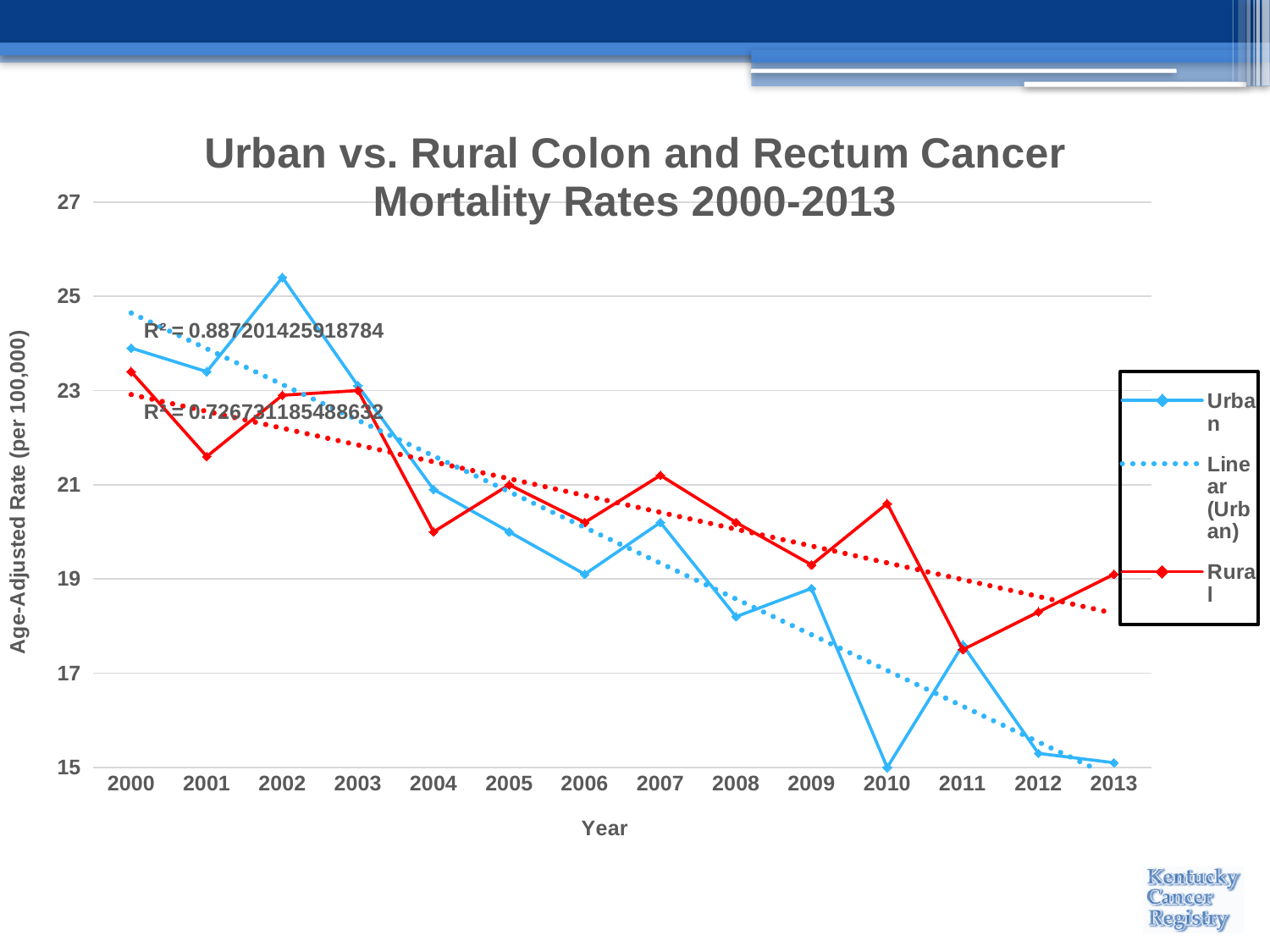
Does the Urban mortality rate generally rise or fall from 2000 to 2013? Fall In 2010, which series has the higher value, Urban or Rural? Rural Is the Urban value for 2013 greater or less than 17? less In which year is the Urban mortality rate highest? 2002 How many years are plotted along the x axis? 14 In which year is the Rural mortality rate lowest? 2011 Is the Urban value for 2002 greater or less than 25? greater Is the Rural value for 2011 greater or less than 19? less What is the title of the chart? Urban vs. Rural Colon and Rectum Cancer Mortality Rates 2000-2013 In which year is the Urban mortality rate lowest? 2010 What kind of chart is shown on the slide? Line chart How many entries does the chart's legend list? 3